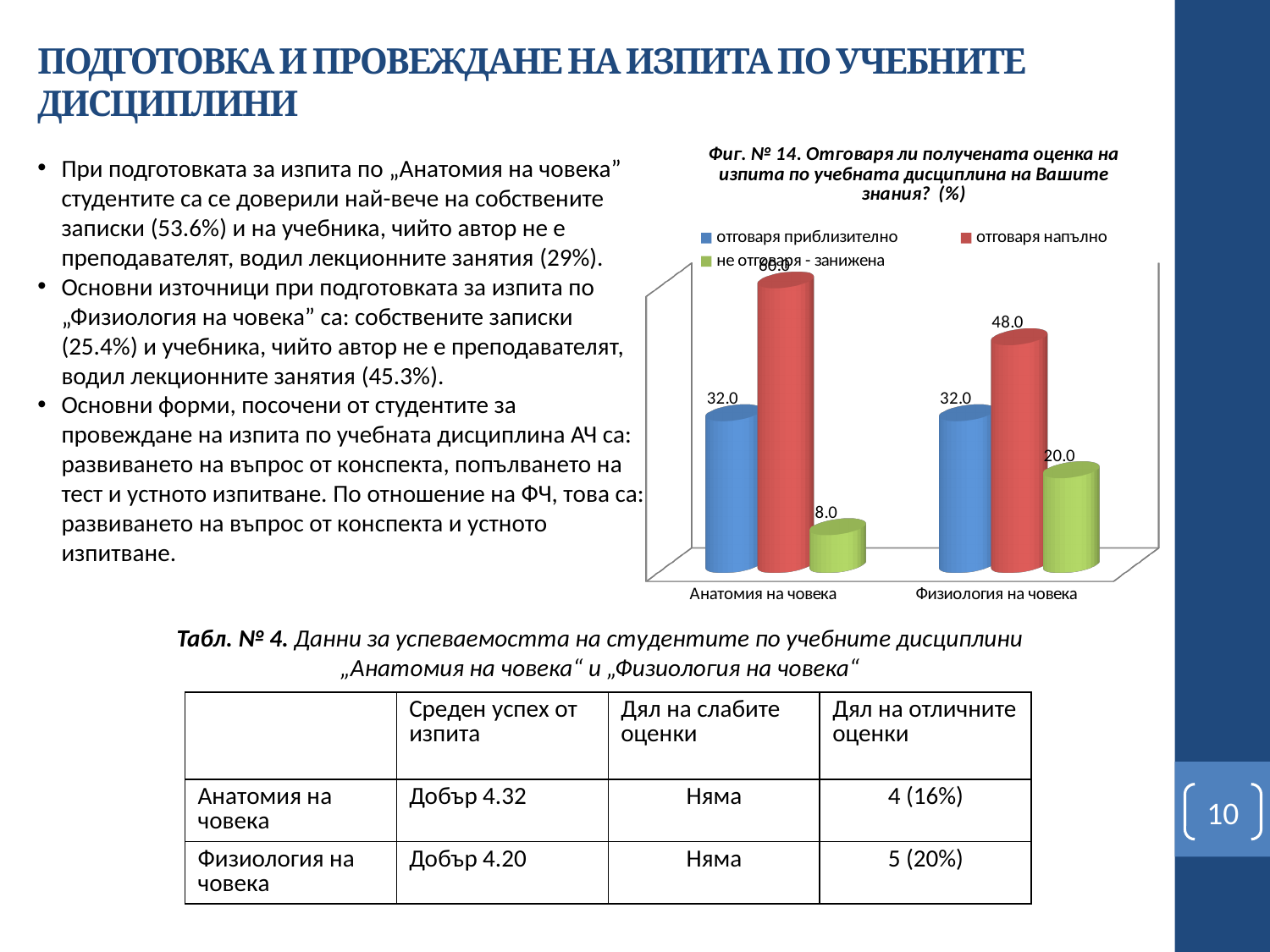
What type of chart is shown in Фиг. № 14? bar chart What is the difference between the "не отговаря - занижена" values for Физиология на човека and Анатомия на човека? 12.0 How many categories are shown on the x axis of the chart? 2 Which is larger: the "отговаря напълно" value for Анатомия на човека or for Физиология на човека? Анатомия на човека How many series does the legend of the chart list? 3 What is the value for "не отговаря - занижена" for Физиология на човека? 20.0 Which colour represents the series "отговаря напълно" in the chart? red What is the value for "отговаря приблизително" for Анатомия на човека? 32.0 What is the value for "отговаря напълно" for Физиология на човека? 48.0 Which series has the lowest value for Анатомия на човека? не отговаря - занижена What is the value for "не отговаря - занижена" for Анатомия на човека? 8.0 Which series has the highest value for Физиология на човека? отговаря напълно